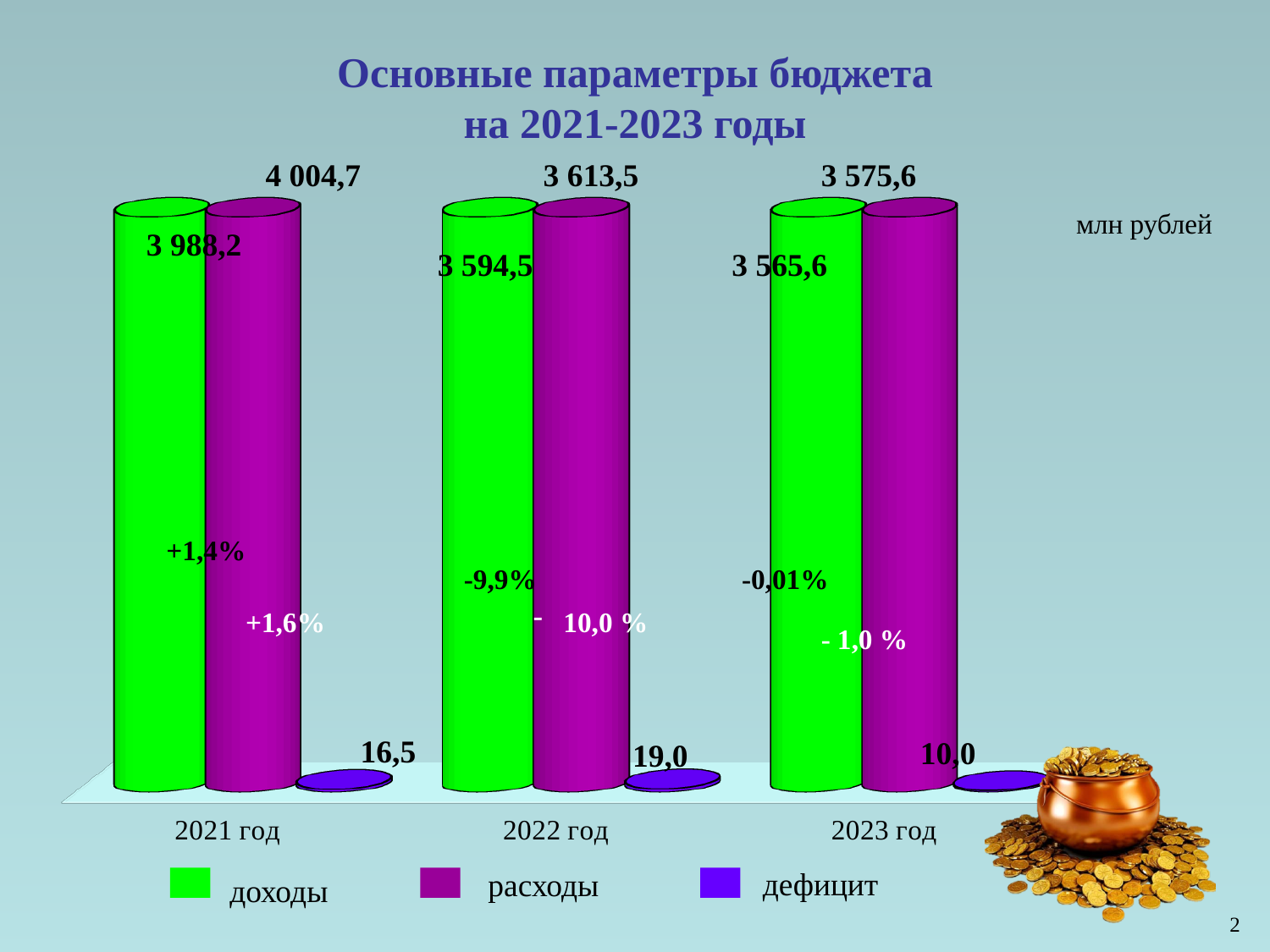
How many years are shown on the x axis? 3 What is the value of дефицит for 2023 год? 10,0 What is the value of расходы for 2023 год? 3 575,6 In which year is доходы the lowest? 2023 год What is the difference between расходы and доходы in 2021 год? 16,5 Which is larger in 2022 год, доходы or расходы? расходы What is the value of доходы for 2021 год? 3 988,2 In which year is дефицит the highest? 2022 год What is the value of расходы for 2022 год? 3 613,5 What kind of chart is shown on the slide? bar chart How many series does the legend list? 3 Do the values of доходы rise or fall from 2021 год to 2023 год? fall